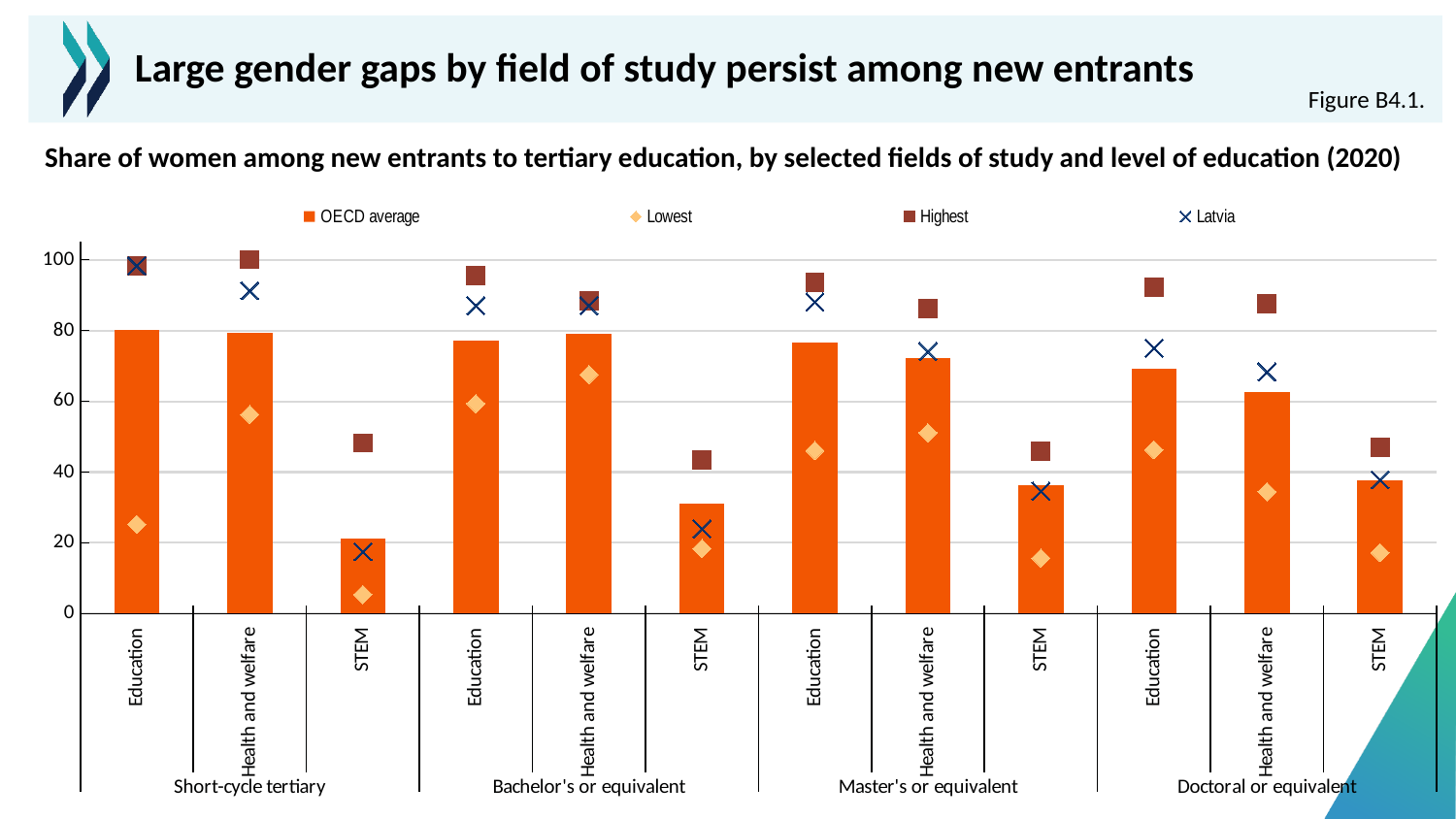
How many series does the legend list? 4 Is the OECD average for STEM at the short-cycle tertiary level greater or less than 40? less At the Bachelor's or equivalent level, which has the larger OECD average: Education or STEM? Education How many OECD average bars are plotted in the chart? 12 How many levels of education are shown along the x axis? 4 Does the OECD average for STEM rise or fall moving from short-cycle tertiary to Doctoral or equivalent? rise Is the Highest value for Health and welfare at the short-cycle tertiary level greater or less than 80? greater Is the OECD average for Education at the short-cycle tertiary level greater or less than 60? greater At the Doctoral or equivalent level, which has the larger OECD average: Education or Health and welfare? Education Which field and level has the lowest OECD average bar in the chart? STEM, short-cycle tertiary What kind of chart is shown on the slide? bar chart